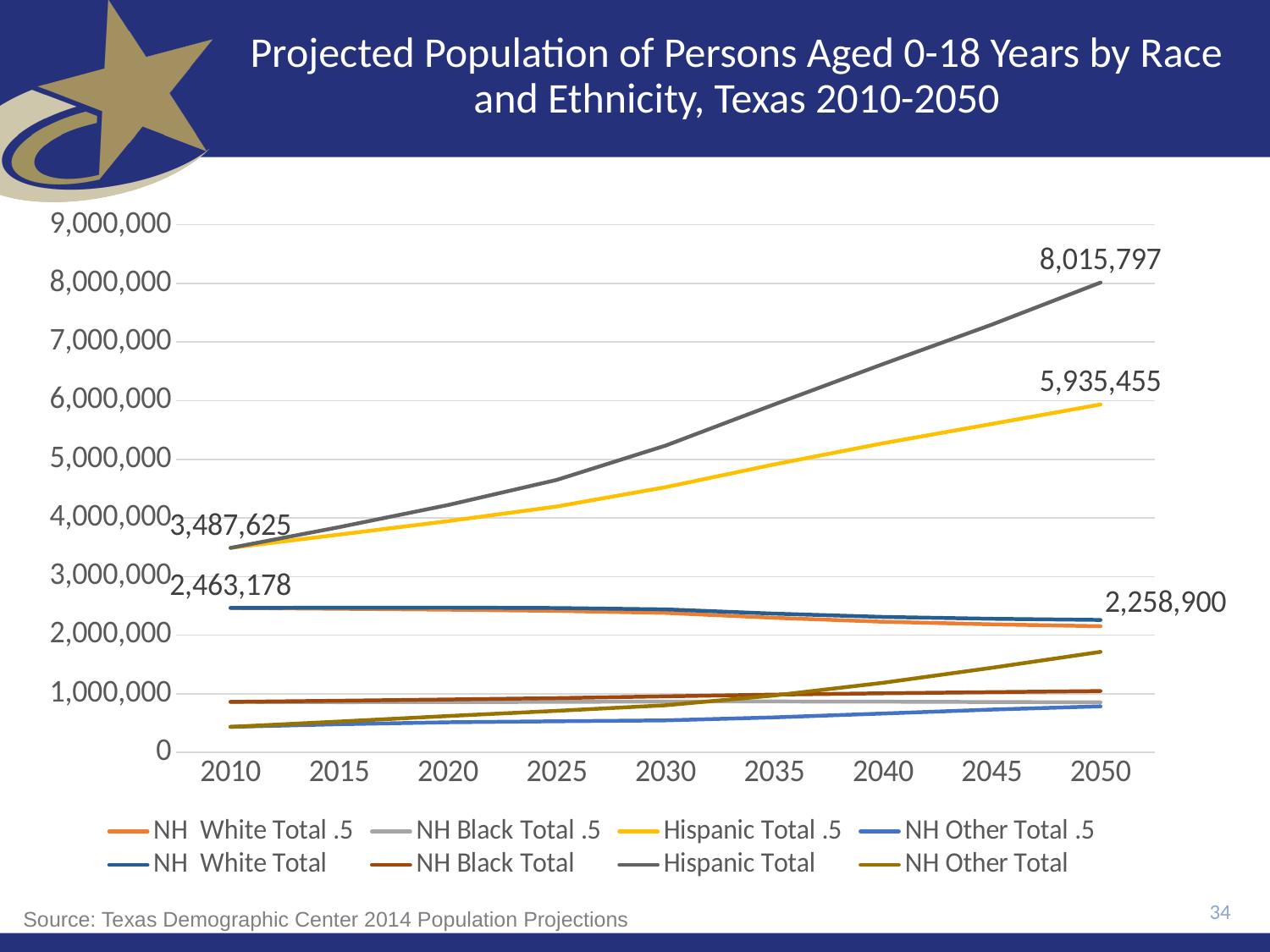
What is the value for NH White Total in 2010? 2,463,178 What is the projected value for Hispanic Total .5 in 2050? 5,935,455 Which series has the highest value in 2050? Hispanic Total Is the value for Hispanic Total .5 in 2030 greater or less than 5,000,000? less How many series does the legend list? 8 What is the difference between the 2050 values for Hispanic Total and Hispanic Total .5? 2,080,342 By how much does Hispanic Total increase from 2010 to 2050? 4,528,172 How many years are shown on the x axis? 9 What type of chart is shown on the slide? Line chart Is the value for NH Other Total in 2050 greater or less than 1,000,000? greater What is the projected value for Hispanic Total in 2050? 8,015,797 What is the value for Hispanic Total in 2010? 3,487,625